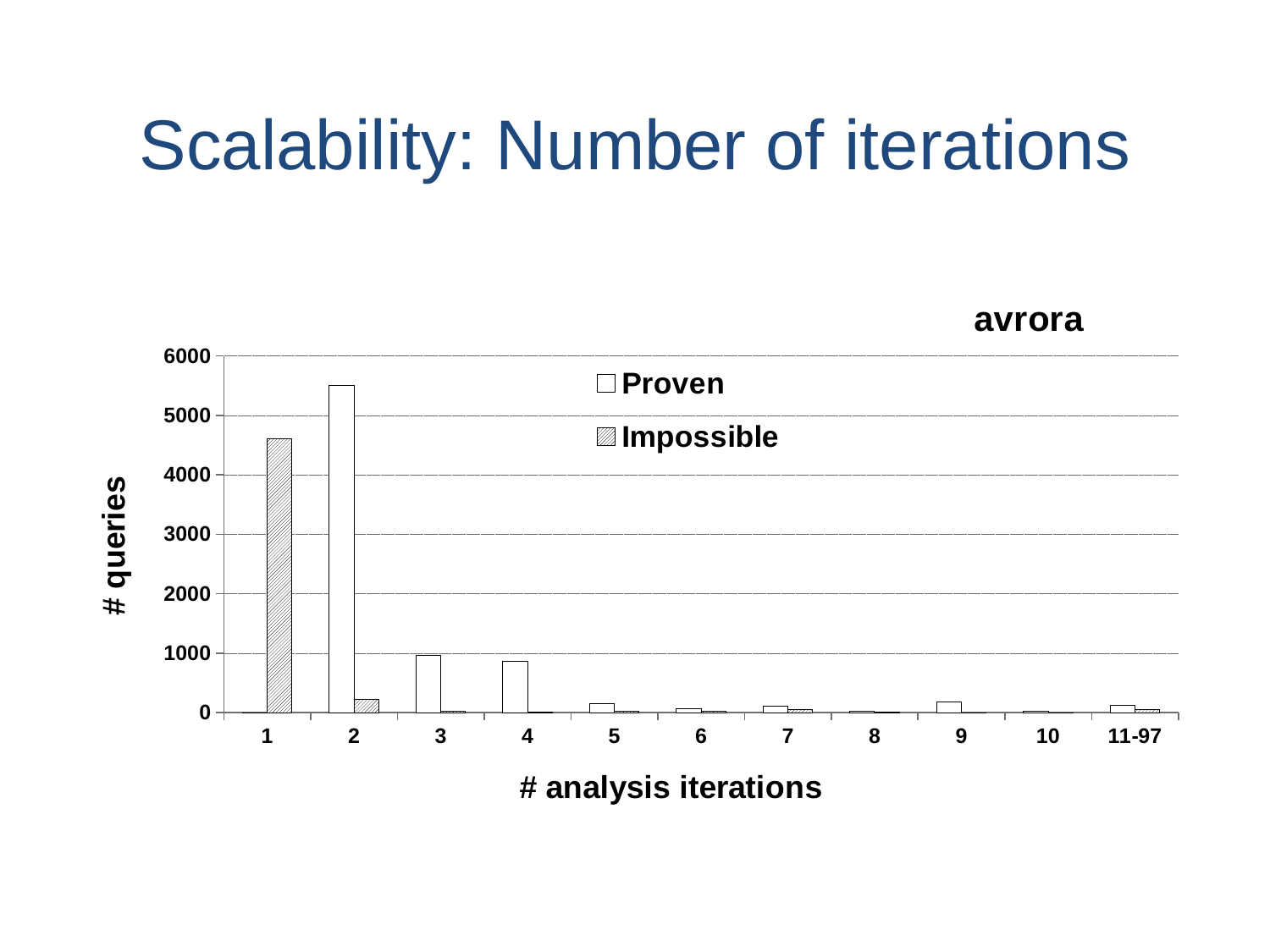
At 1 analysis iteration, which series has the larger value, Proven or Impossible? Impossible Is the Impossible value at 2 analysis iterations greater or less than 1000? less Which is larger: the Proven bar at 2 iterations or the Impossible bar at 1 iteration? Proven at 2 iterations What is the label on the y axis of the chart? # queries How many categories are shown on the x axis? 11 Is the Impossible value at 1 analysis iteration greater or less than 4000? greater What kind of chart is shown on the slide? bar chart For which number of analysis iterations is the Proven bar highest? 2 Is the Proven value at 2 analysis iterations greater or less than 5000? greater How many series does the legend list? 2 For which number of analysis iterations is the Impossible bar highest? 1